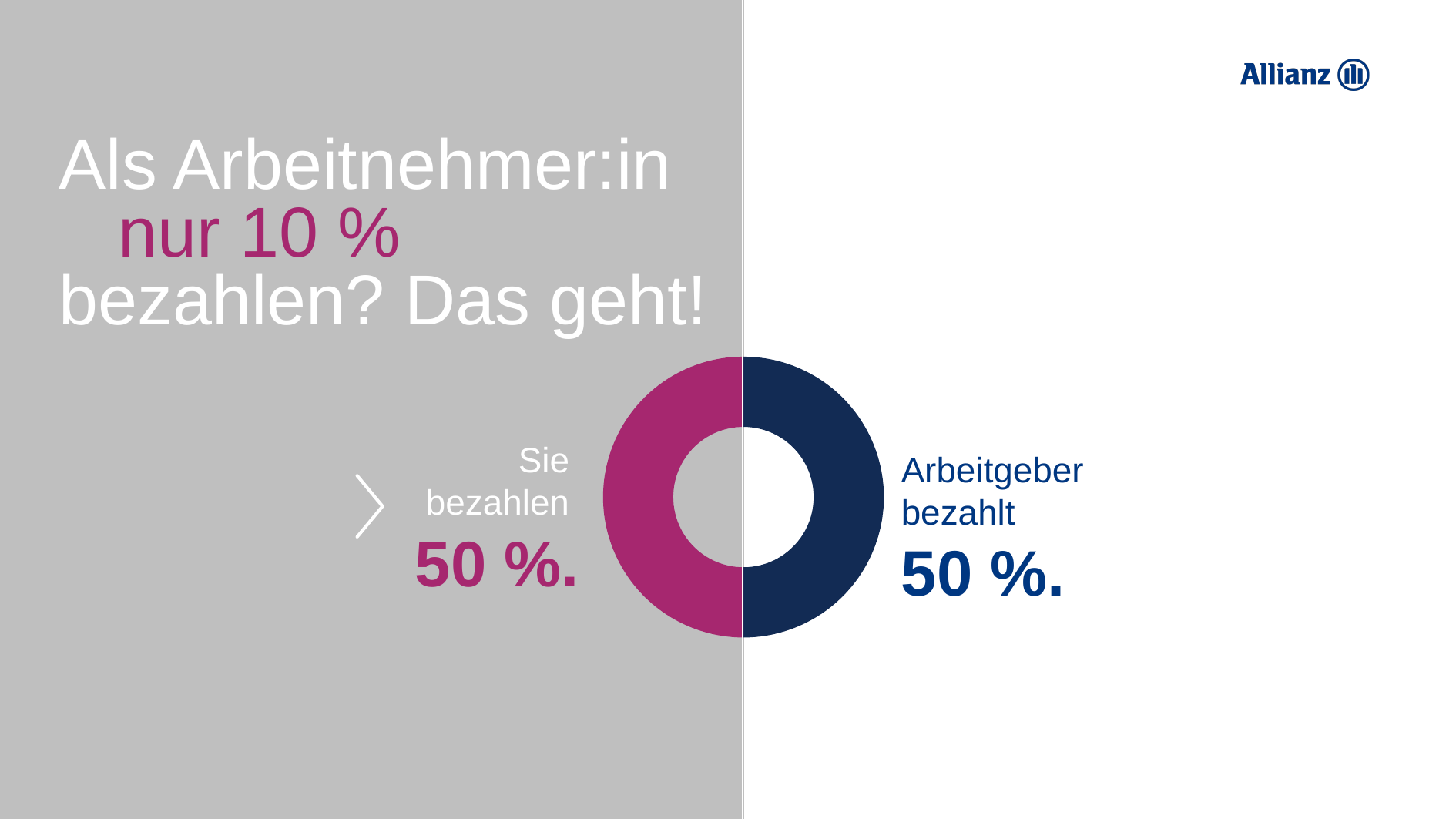
What is the total of the two slices in the doughnut chart? 100 % What is the value shown for "Sie bezahlen"? 50 % What share of the doughnut chart is labelled "Arbeitgeber bezahlt"? 50 % What share of the doughnut chart is labelled "Sie bezahlen"? 50 % What kind of chart is shown on the slide? Doughnut (pie) chart Which colour is the "Sie bezahlen" slice of the doughnut chart? Magenta (purple-pink) Which colour is the "Arbeitgeber bezahlt" slice of the doughnut chart? Dark blue What is the difference between the "Sie bezahlen" share and the "Arbeitgeber bezahlt" share? 0 % What is the value shown for "Arbeitgeber bezahlt"? 50 % How many slices does the doughnut chart have? 2